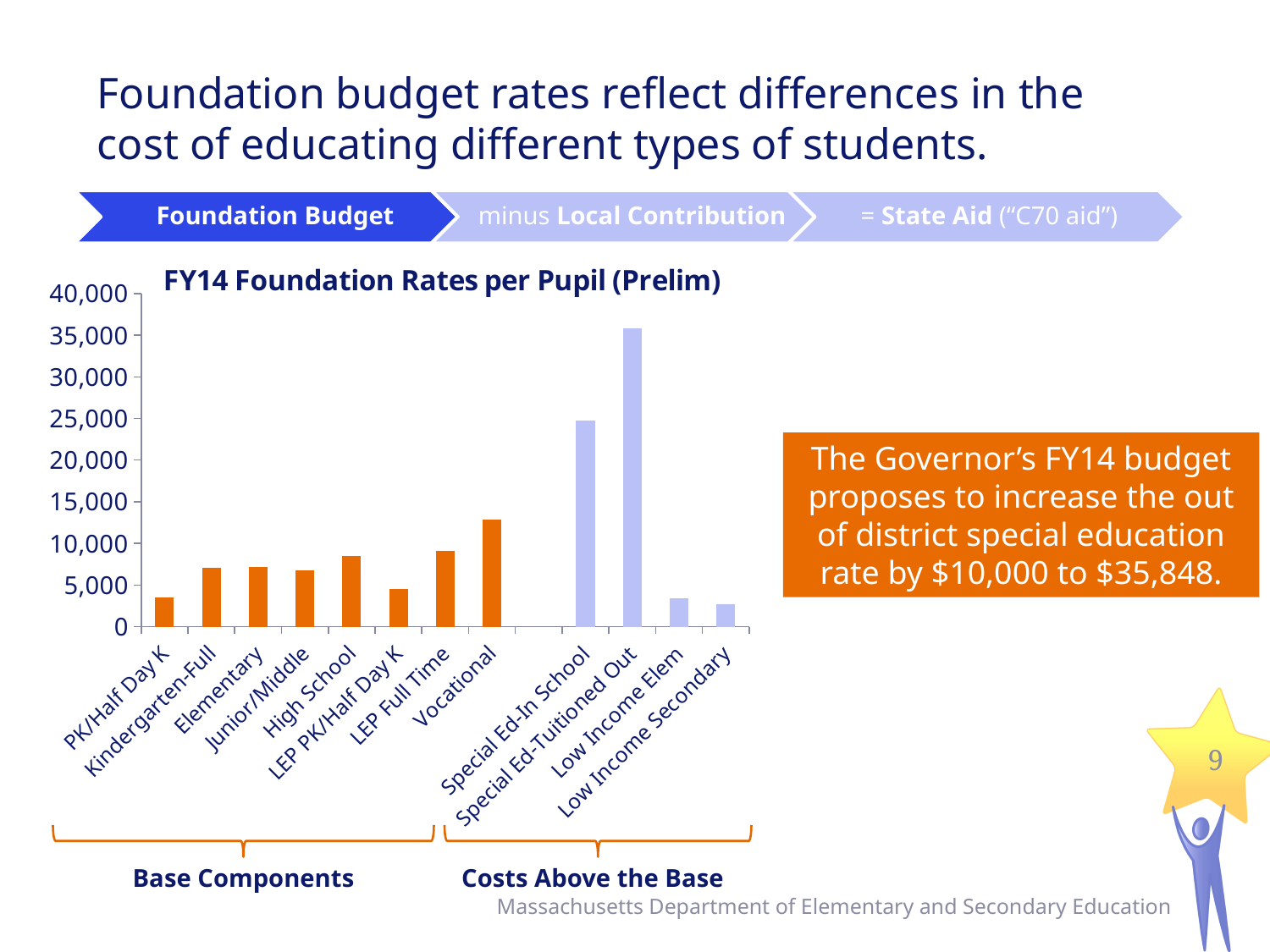
Which is larger, the value for Vocational or the value for High School? Vocational Is the value for Vocational greater or less than 10,000? greater How many categories are plotted on the x axis of the chart? 12 Which is larger, the value for Special Ed-In School or the value for Special Ed-Tuitioned Out? Special Ed-Tuitioned Out Which category has the lowest foundation rate per pupil? Low Income Secondary What is the title of the chart? FY14 Foundation Rates per Pupil (Prelim) What label is given to the group of bars on the right side of the chart (the light blue bars)? Costs Above the Base Is the value for Special Ed-Tuitioned Out greater or less than 30,000? greater What kind of chart is shown on the slide? bar chart Which category has the highest foundation rate per pupil? Special Ed-Tuitioned Out Is the value for Special Ed-In School greater or less than 20,000? greater